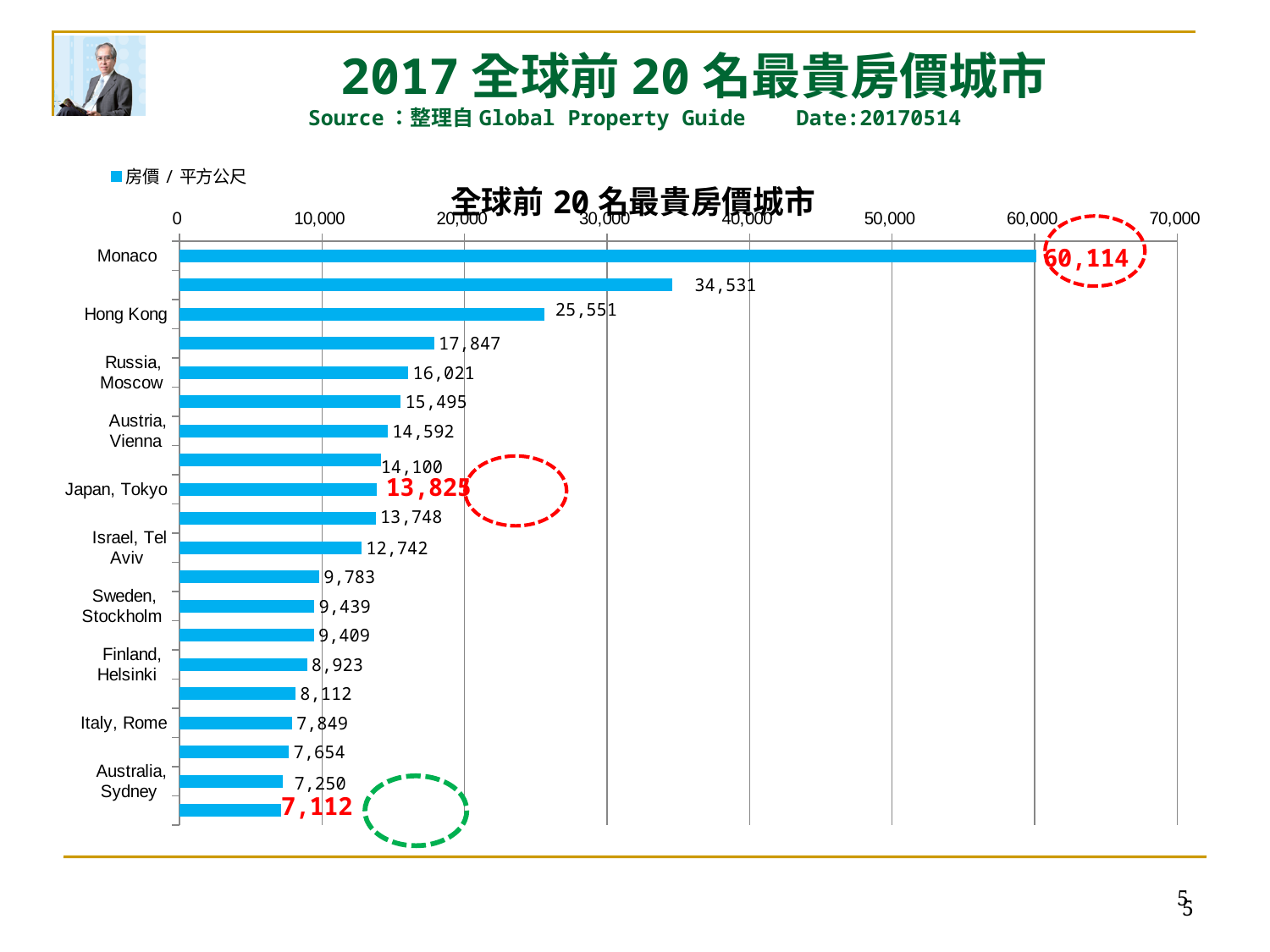
What is the difference between the values for Monaco and Hong Kong? 34,563 What is the value for Australia, Sydney? 7,250 What is the value for Russia, Moscow? 16,021 How many series does the legend list? 1 What is the value for Monaco? 60,114 How many bars are plotted in the chart? 20 What is the value for Hong Kong? 25,551 What kind of chart is shown on the slide? bar chart Which has a larger value, Austria, Vienna or Israel, Tel Aviv? Austria, Vienna Is the value for Sweden, Stockholm greater or less than 10,000? less Which city has the highest value? Monaco What is the value for Japan, Tokyo? 13,825